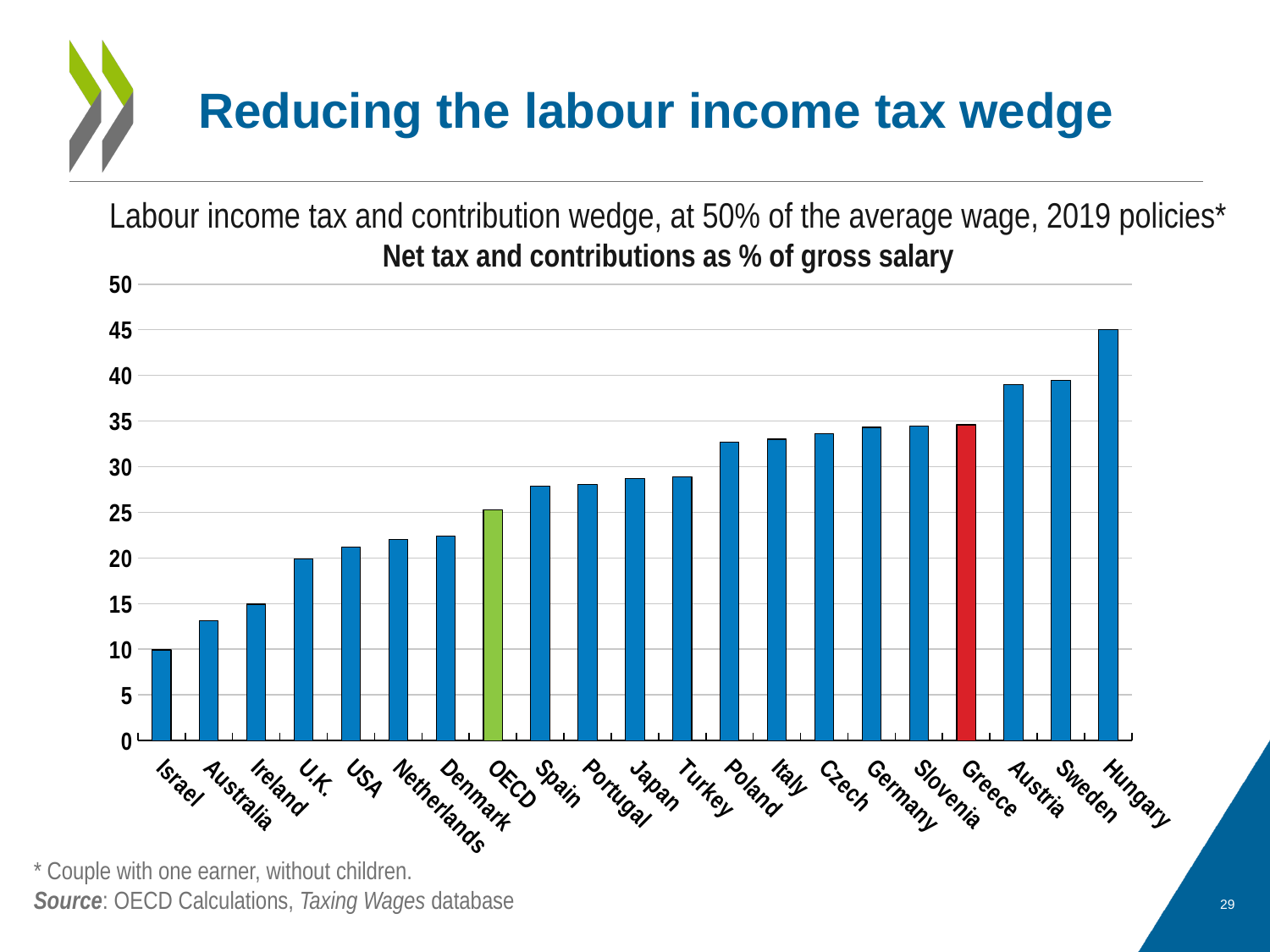
Is the value for Australia greater or less than 15? less Do the values rise or fall moving from left to right along the x axis? rise Is the value for Greece greater or less than 30? greater Which country has the lowest net tax and contributions as % of gross salary? Israel Which country has the highest net tax and contributions as % of gross salary? Hungary Which bar is coloured red in the chart? Greece Which is larger, the value for Austria or the value for Poland? Austria How many bars are plotted in the chart? 21 What kind of chart is shown on the slide? bar chart Which is larger, the value for Spain or the value for Denmark? Spain